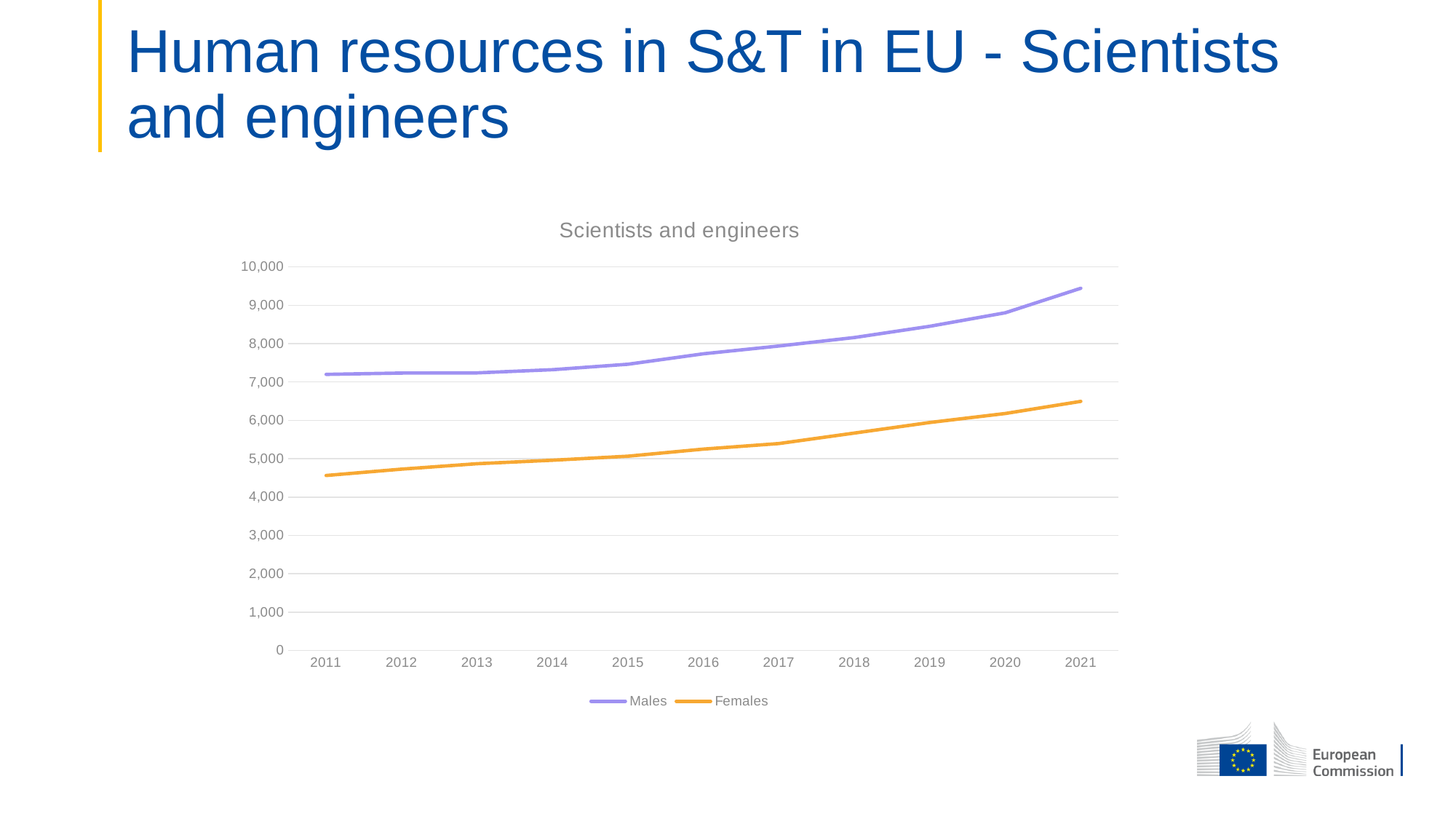
How many series does the legend list? 2 Is the value for Males in 2021 greater or less than 9,000? greater How many years are plotted along the x axis? 11 What kind of chart is shown on the slide? line chart In which year is the value for Females lowest? 2011 Is the value for Females in 2011 greater or less than 5,000? less What is the title of the chart? Scientists and engineers Do the values for Males rise or fall from 2011 to 2021? rise In 2015, which series has the larger value, Males or Females? Males Is the value for Females in 2021 greater or less than 6,000? greater In which year is the value for Males highest? 2021